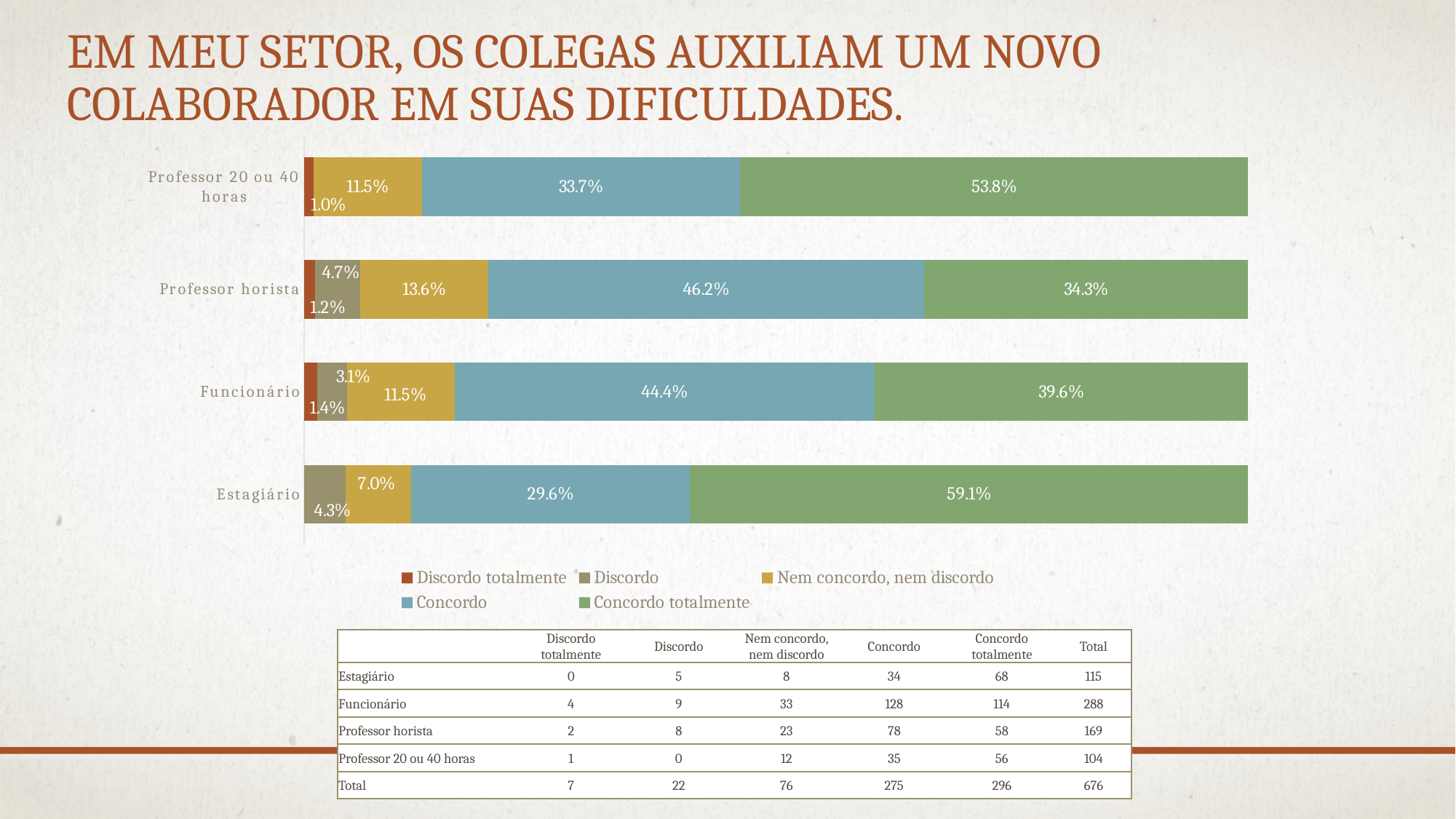
Which category has the highest "Concordo totalmente" value? Estagiário What kind of chart is shown on the slide? Stacked bar chart What is the "Discordo totalmente" value for Professor 20 ou 40 horas? 1.0% What is the difference between the "Concordo totalmente" values for Professor 20 ou 40 horas and Professor horista? 19.5% What is the "Concordo" value for Professor horista? 46.2% Which is larger: the "Concordo" value for Funcionário or for Professor 20 ou 40 horas? Funcionário What is the "Nem concordo, nem discordo" value for Funcionário? 11.5% Which category has the lowest "Concordo" value? Estagiário What is the "Concordo totalmente" value for Estagiário? 59.1% How many categories are plotted on the chart? 4 How many series does the chart legend list? 5 Which legend entry is shown in green? Concordo totalmente